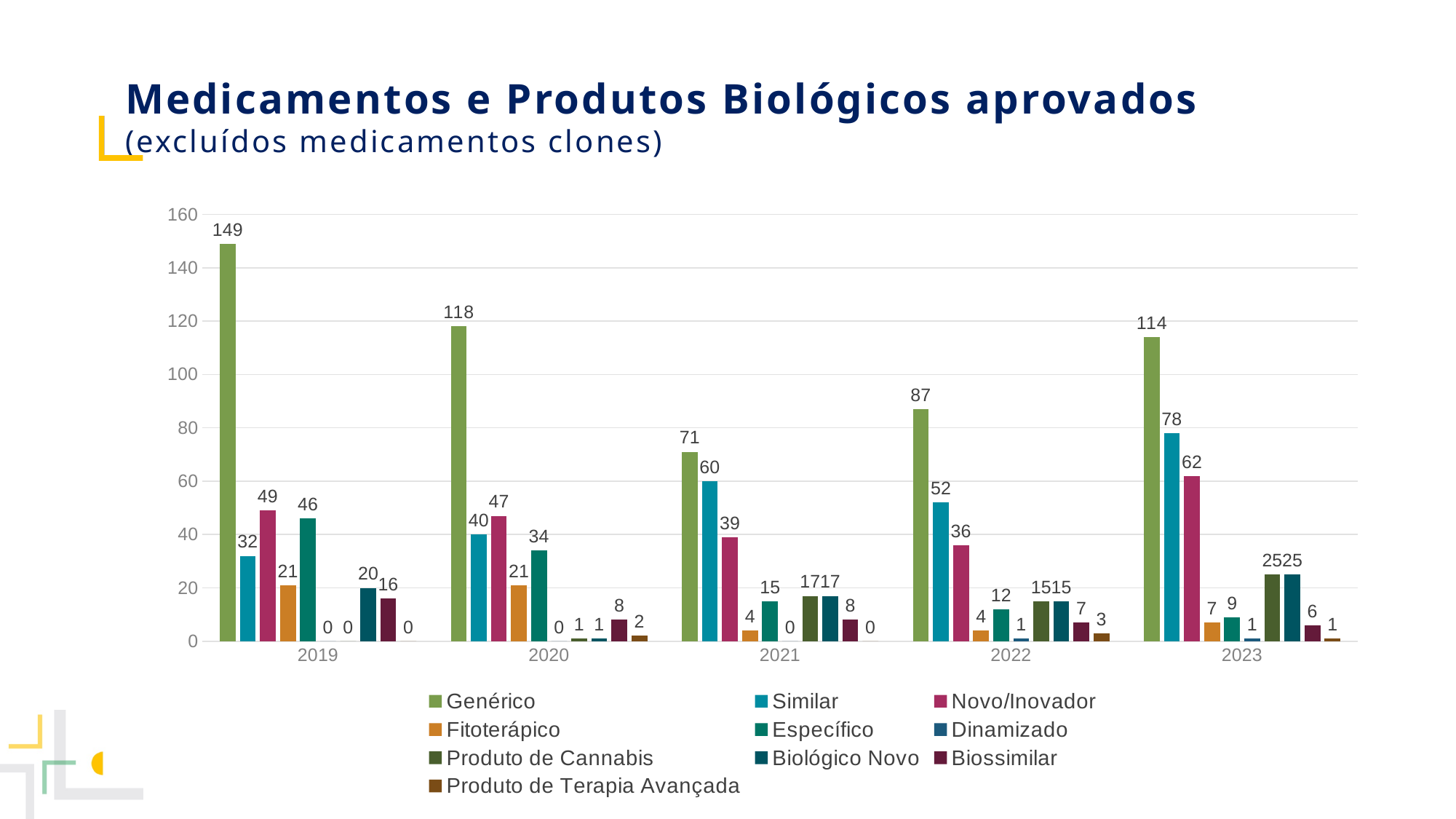
In which year is the Genérico value lowest? 2021 How many years are shown on the x axis? 5 In which year is the Similar value highest? 2023 What is the value for Similar in 2023? 78 What is the subtitle shown in parentheses under the chart title? (excluídos medicamentos clones) Which is larger in 2021: Similar or Novo/Inovador? Similar What is the difference between the Genérico values for 2019 and 2020? 31 What is the value for Genérico in 2019? 149 What kind of chart is shown on the slide? Bar chart How many series does the legend list? 10 What is the value for Específico in 2020? 34 What is the value for Novo/Inovador in 2021? 39